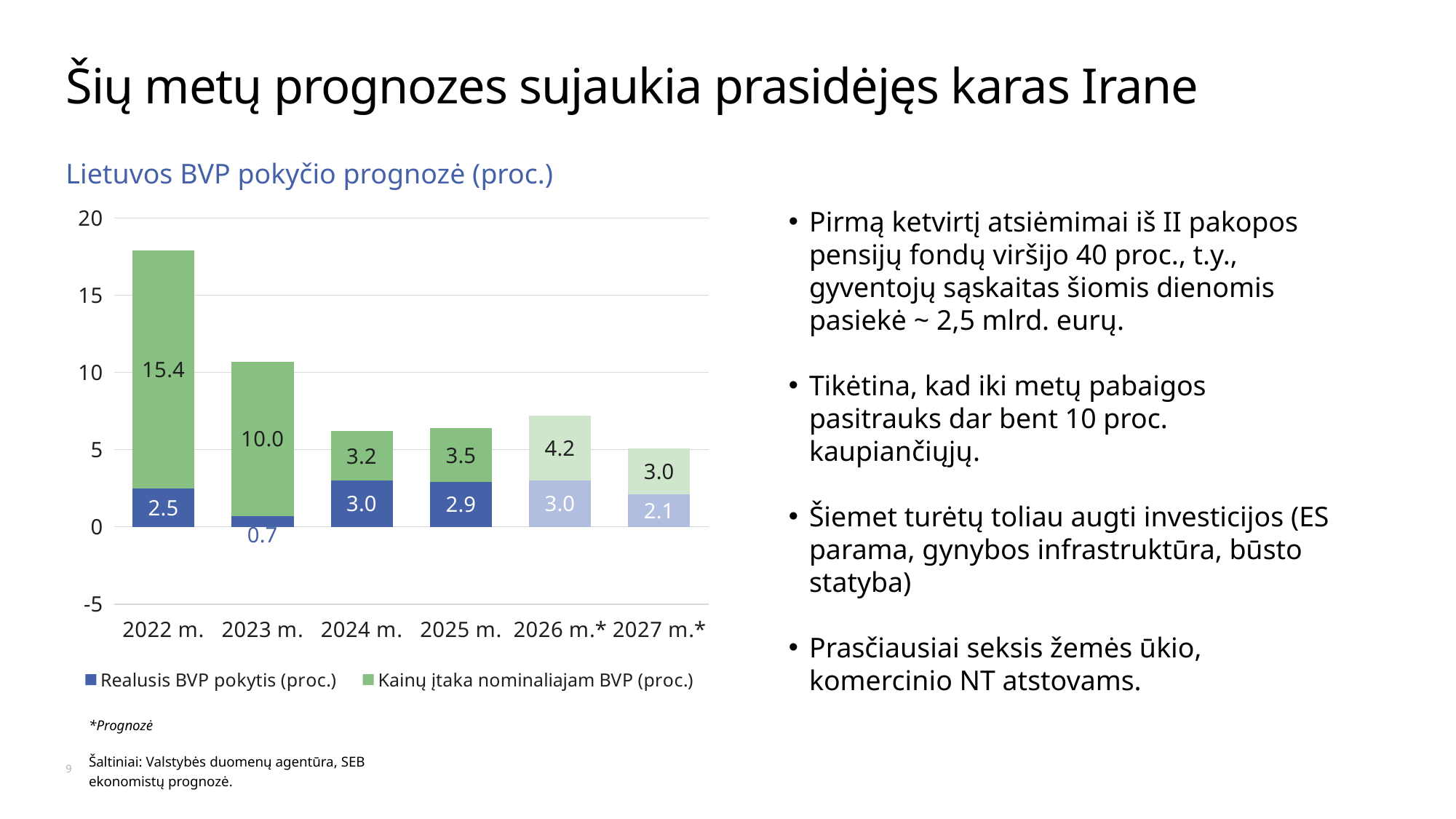
What is the total height of the stacked bar for 2025 m.? 6.4 How many years are shown on the x axis of the chart? 6 What is the difference between the Kainų įtaka nominaliajam BVP (proc.) values for 2022 m. and 2023 m.? 5.4 What type of chart is shown on the slide? Stacked bar chart What is the value of Realusis BVP pokytis (proc.) for 2027 m.*? 2.1 Which year has the lowest value for Realusis BVP pokytis (proc.)? 2023 m. What is the total height of the stacked bar for 2023 m.? 10.7 What is the value of Kainų įtaka nominaliajam BVP (proc.) for 2022 m.? 15.4 What is the value of Realusis BVP pokytis (proc.) for 2024 m.? 3.0 Which is larger: Kainų įtaka nominaliajam BVP (proc.) for 2026 m.* or for 2027 m.*? 2026 m.* Which year has the highest value for Kainų įtaka nominaliajam BVP (proc.)? 2022 m. How many series does the chart legend list? 2